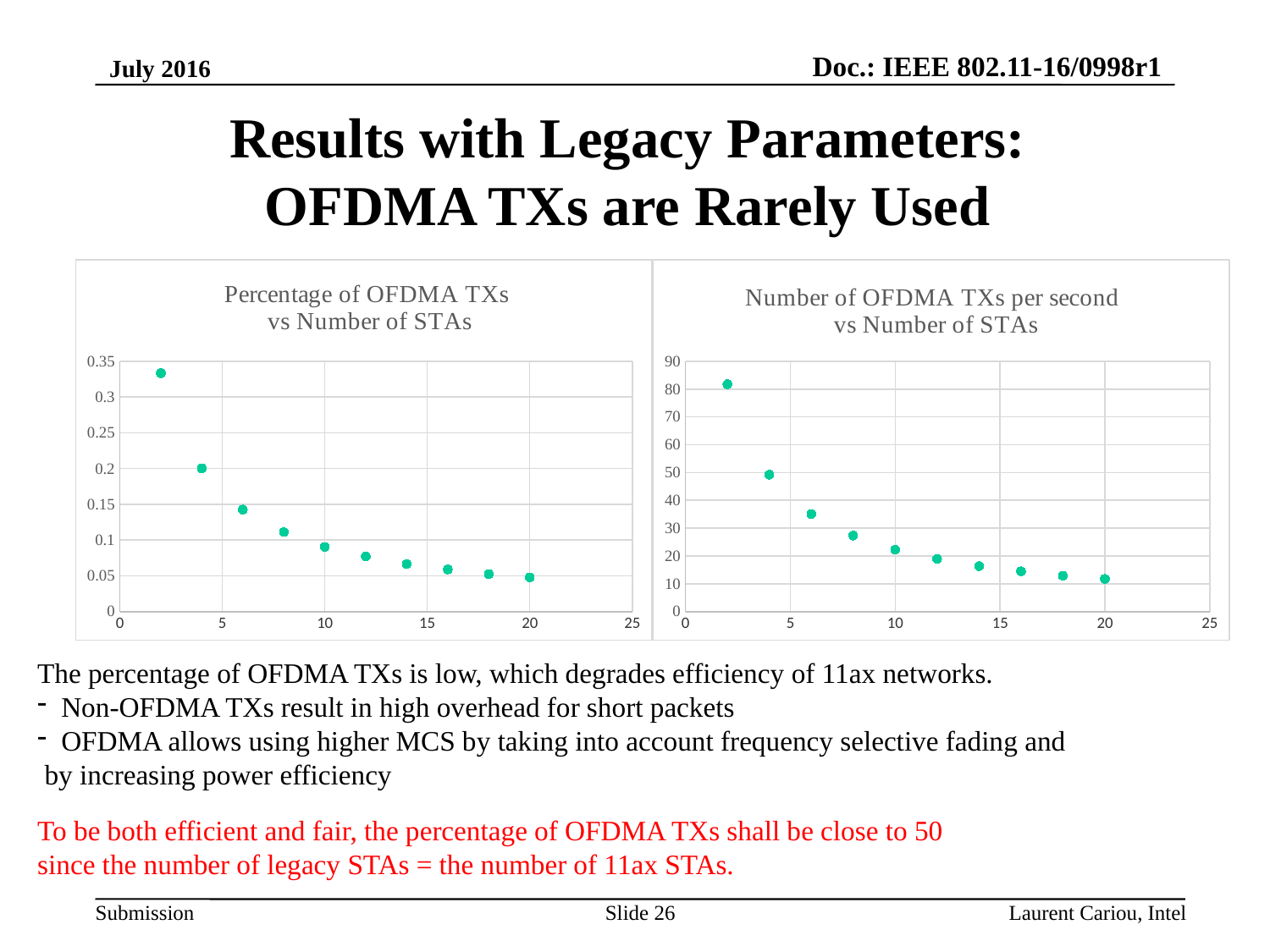
How many data points are plotted in the 'Number of OFDMA TXs per second vs Number of STAs' chart? 10 In the 'Percentage of OFDMA TXs vs Number of STAs' chart, at which number of STAs is the value lowest? 20 In the 'Percentage of OFDMA TXs vs Number of STAs' chart, is the value at 20 STAs greater or less than 0.1? less In the 'Number of OFDMA TXs per second vs Number of STAs' chart, is the value at 2 STAs greater or less than 70? greater In the 'Number of OFDMA TXs per second vs Number of STAs' chart, at which number of STAs is the value highest? 2 In the 'Number of OFDMA TXs per second vs Number of STAs' chart, which is larger, the value at 4 STAs or the value at 10 STAs? 4 STAs What kind of chart is the 'Percentage of OFDMA TXs vs Number of STAs' chart? scatter chart In the 'Number of OFDMA TXs per second vs Number of STAs' chart, do the values rise or fall as the number of STAs increases? fall In the 'Percentage of OFDMA TXs vs Number of STAs' chart, is the value at 2 STAs greater or less than 0.3? greater What is the title of the chart on the right side of the slide? Number of OFDMA TXs per second vs Number of STAs In the 'Percentage of OFDMA TXs vs Number of STAs' chart, do the values rise or fall as the number of STAs increases? fall